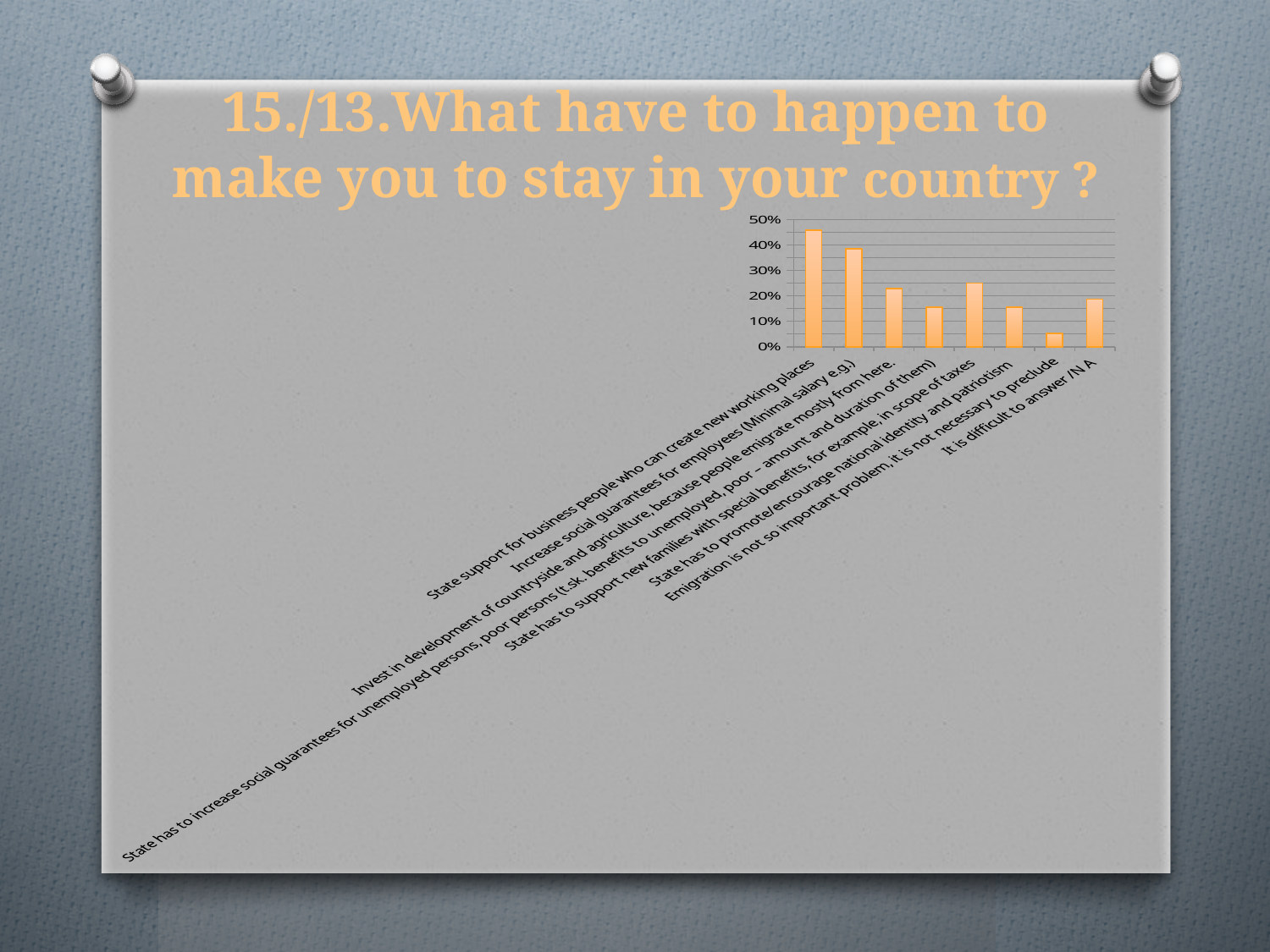
What is the highest value shown on the chart's vertical axis? 50% Is the value for "Emigration is not so important problem, it is not necessary to preclude" greater or less than 10%? less What kind of chart is shown on the slide? bar chart Which is larger: the value for "State has to support new families with special benefits, for example, in scope of taxes" or the value for "State has to promote/encourage national identity and patriotism"? State has to support new families with special benefits, for example, in scope of taxes What is the title of the slide containing the chart? 15./13.What have to happen to make you to stay in your country ? Is the value for "State support for business people who can create new working places" greater or less than 40%? greater Which category has the highest value in the chart? State support for business people who can create new working places Which is larger: the value for "Increase social guarantees for employees (Minimal salary e.g.)" or the value for "Invest in development of countryside and agriculture, because people emigrate mostly from here."? Increase social guarantees for employees (Minimal salary e.g.) Is the value for "Increase social guarantees for employees (Minimal salary e.g.)" greater or less than 30%? greater How many categories (bars) does the chart show? 8 Which category has the lowest value in the chart? Emigration is not so important problem, it is not necessary to preclude